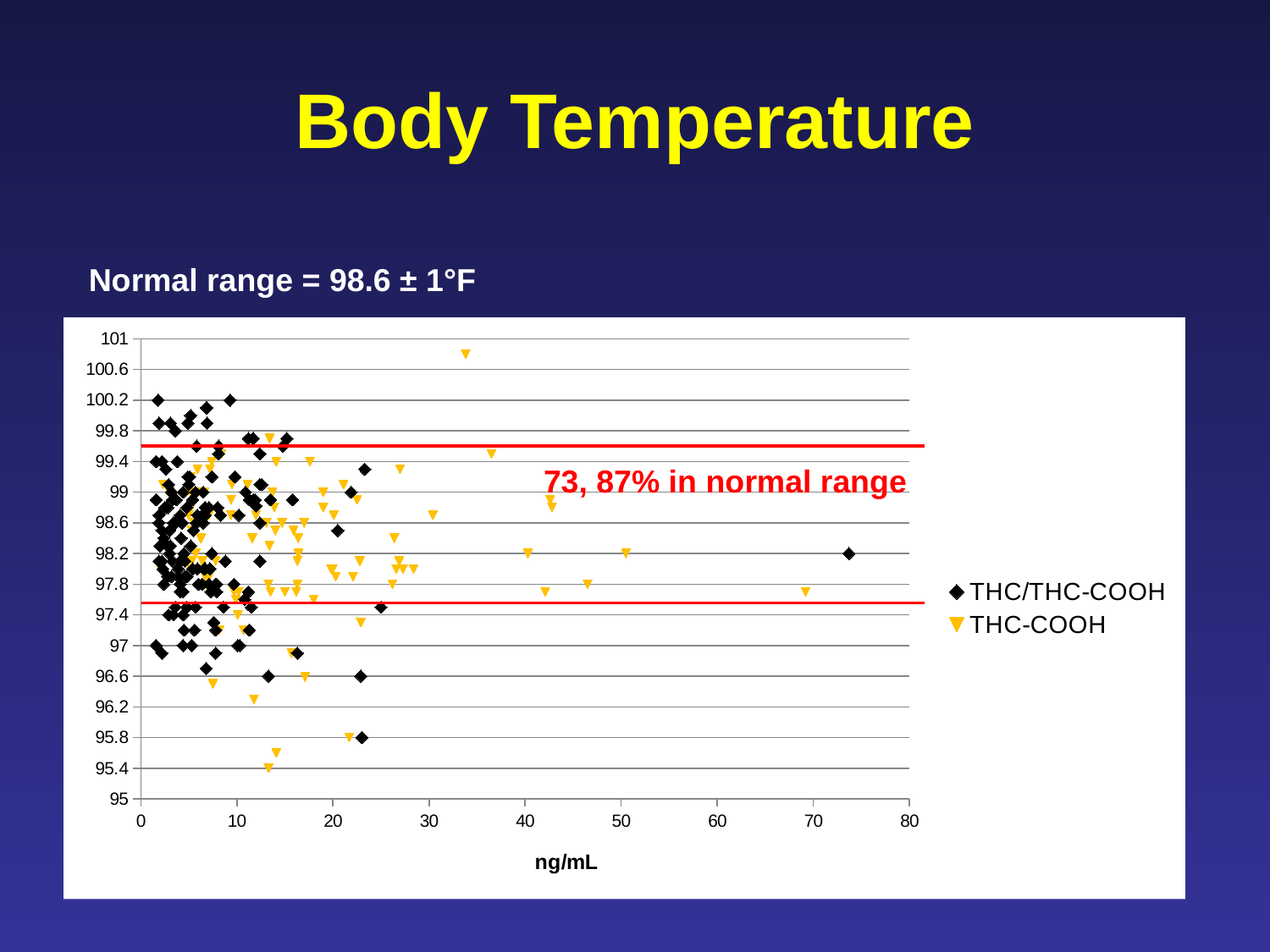
What kind of chart is shown on the slide? Scatter plot Which series contains the highest body temperature point on the chart? THC-COOH Which series contains the lowest body temperature point on the chart? THC-COOH Is the highest THC-COOH point (near 34 ng/mL) greater or less than 100.6? greater What is the maximum value shown on the y axis? 101 What is the label on the x axis? ng/mL Is the THC/THC-COOH point plotted near 74 ng/mL greater or less than 98.6? less How many series does the legend list? 2 According to the annotation, how many points fall in the normal range? 73 What are the two series named in the legend? THC/THC-COOH and THC-COOH Is the lowest THC-COOH point (near 13 ng/mL) greater or less than 95.8? less According to the annotation, what percentage of points fall in the normal range? 87%